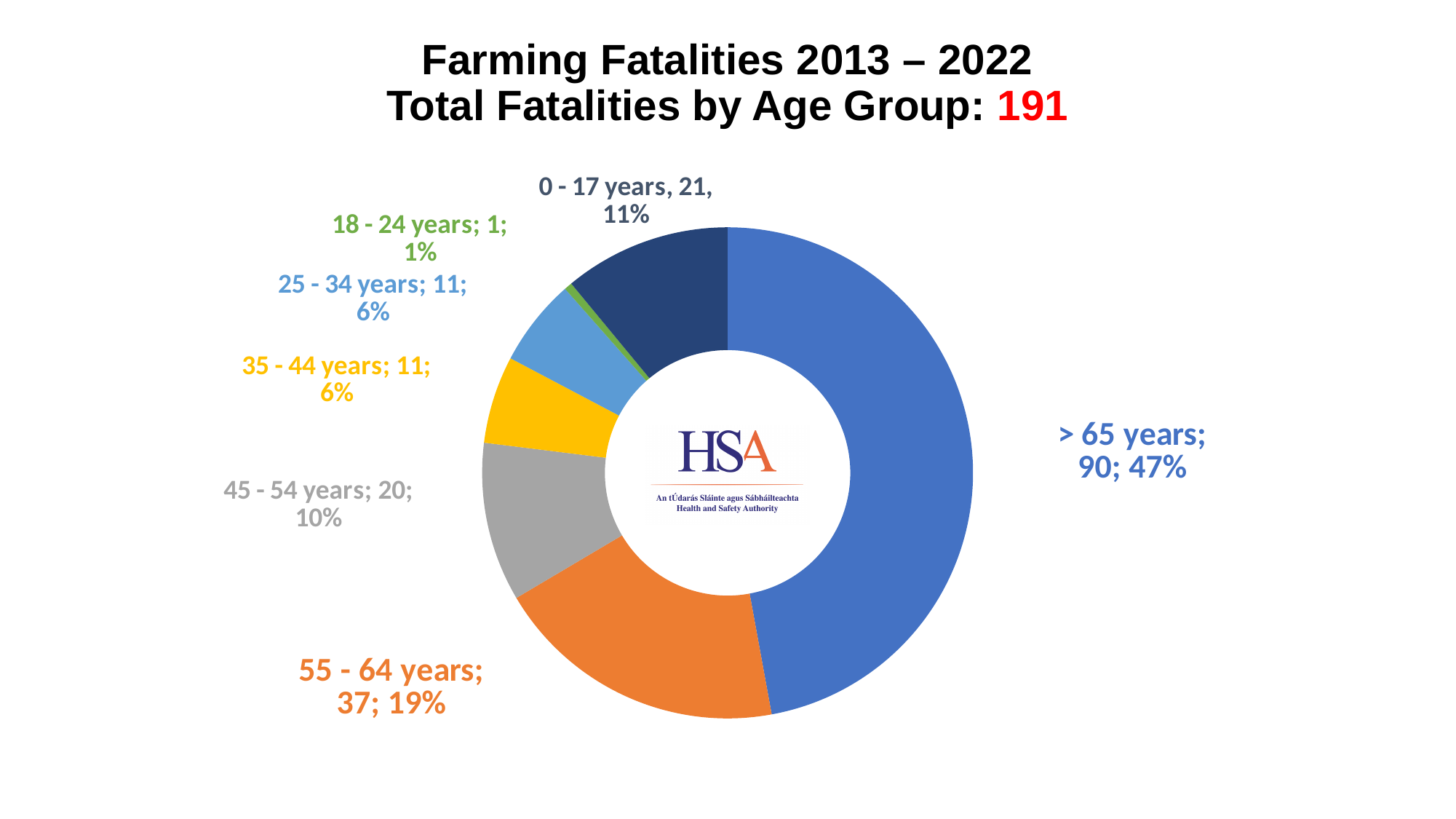
What kind of chart is shown on the slide? Pie chart (doughnut) What is the difference in fatalities between the > 65 years and 55 - 64 years age groups? 53 Which age group has the lowest number of fatalities? 18 - 24 years How many fatalities are shown for the > 65 years age group? 90 Which age group has the highest number of fatalities? > 65 years How many fatalities are shown for the 55 - 64 years age group? 37 What percentage share does the 45 - 54 years age group have? 10% What is the total number of fatalities shown in the chart title? 191 How many age groups are shown in the chart? 7 What percentage share does the 0 - 17 years age group have? 11% What colour is the slice for the 55 - 64 years age group? Orange Which age group has more fatalities, 0 - 17 years or 45 - 54 years? 0 - 17 years